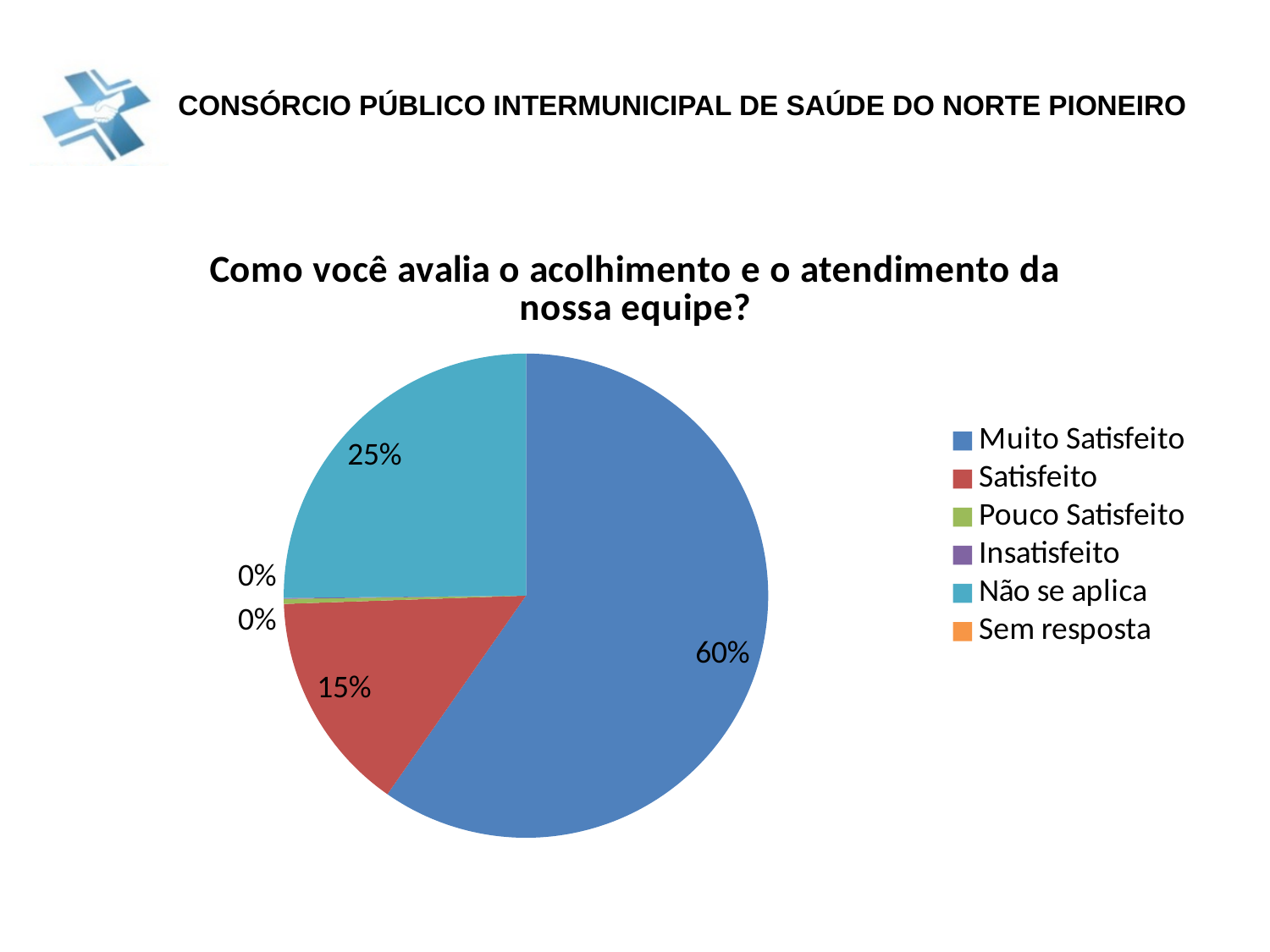
Which category has the largest slice of the pie? Muito Satisfeito What share of the pie is Satisfeito? 15% What is the title of the chart? Como você avalia o acolhimento e o atendimento da nossa equipe? What share of the pie is Não se aplica? 25% What is the difference in percentage points between Não se aplica and Satisfeito? 10 What share of the pie is Muito Satisfeito? 60% How many entries does the legend list? 6 What is the difference in percentage points between Muito Satisfeito and Não se aplica? 35 What is the combined share of Muito Satisfeito and Satisfeito? 75% Which legend entry is shown in red? Satisfeito Which is larger, the slice for Satisfeito or the slice for Não se aplica? Não se aplica What type of chart is shown on the slide? pie chart